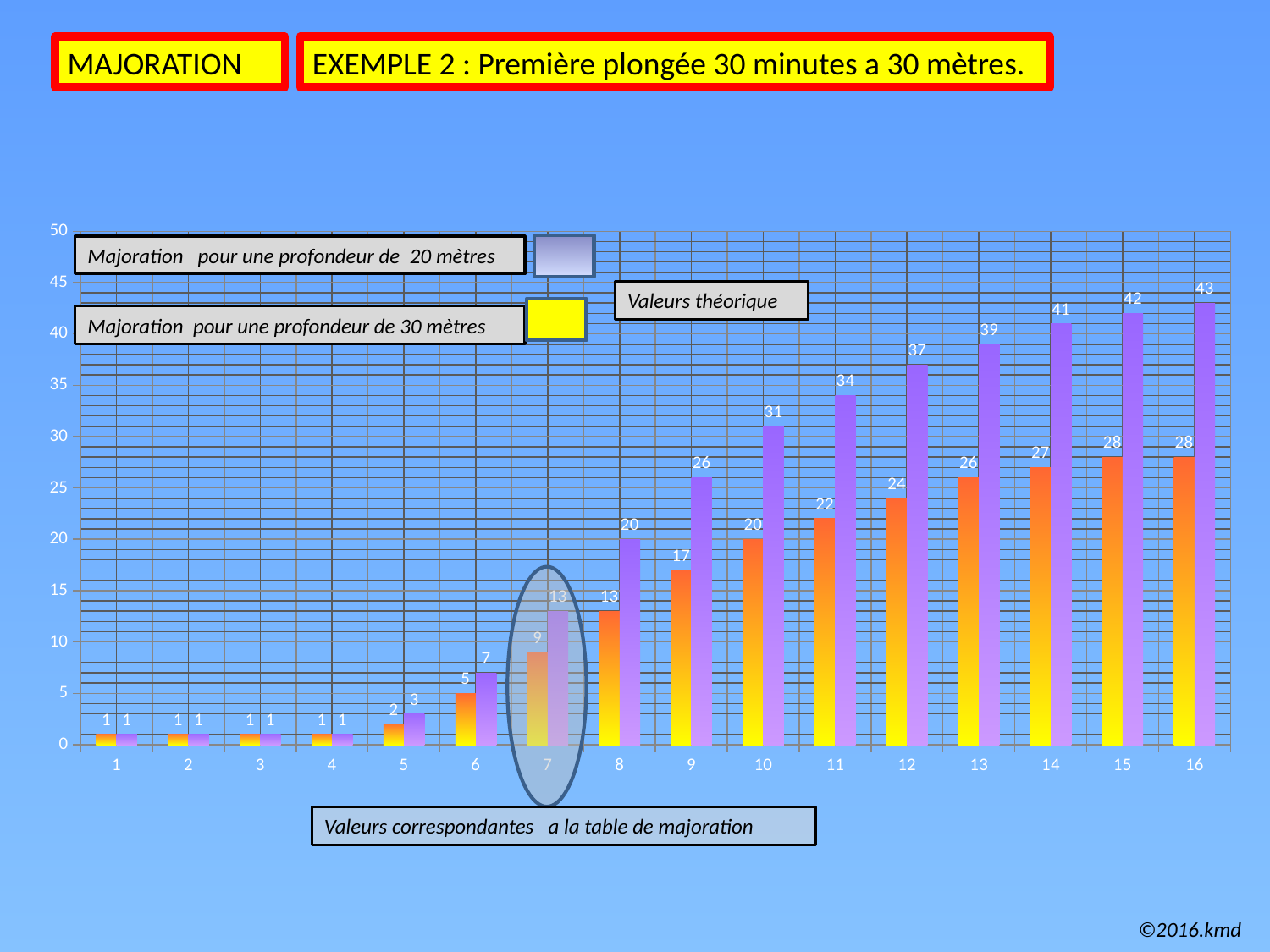
What is the value of the 'Majoration pour une profondeur de 20 mètres' series at category 10? 31 How many series does the legend list? 2 What is the value of the 'Majoration pour une profondeur de 30 mètres' series at category 7? 9 What kind of chart is shown on the slide? bar chart Is the value of the 20 mètres series at category 13 greater or less than 35? greater What is the difference between the 20 mètres and 30 mètres values at category 12? 13 Do the values of the 'Majoration pour une profondeur de 30 mètres' series rise or fall from category 1 to category 16? rise How many categories are shown along the x axis? 16 Which colour represents the 'Majoration pour une profondeur de 30 mètres' series in the legend? yellow Which is larger at category 9: the 20 mètres value or the 30 mètres value? 20 mètres value At which category is the 'Majoration pour une profondeur de 20 mètres' series highest? 16 What is the value of the 'Majoration pour une profondeur de 20 mètres' series at category 16? 43